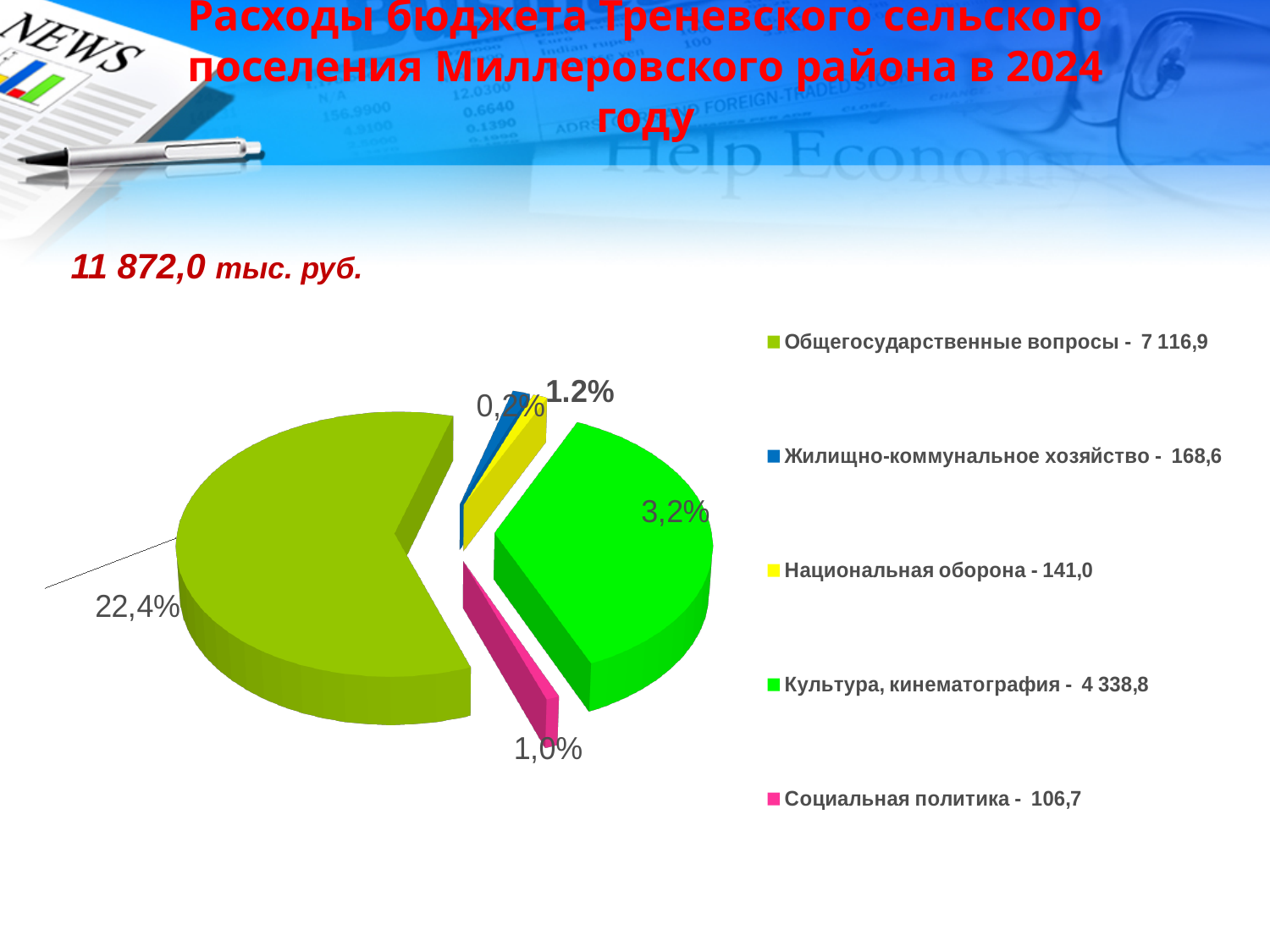
What is the value for Культура, кинематография? 4 338,8 Which is larger: Жилищно-коммунальное хозяйство or Национальная оборона? Жилищно-коммунальное хозяйство What kind of chart is shown on the slide? pie chart How many categories does the pie chart have? 5 What is the value for Жилищно-коммунальное хозяйство? 168,6 What is the value for Социальная политика? 106,7 What is the value for Общегосударственные вопросы? 7 116,9 What is the difference between the values for Общегосударственные вопросы and Культура, кинематография? 2 778,1 What is the value for Национальная оборона? 141,0 Which category has the lowest value? Социальная политика What total budget expenditure amount is stated on the slide? 11 872,0 тыс. руб. Which category has the highest value? Общегосударственные вопросы